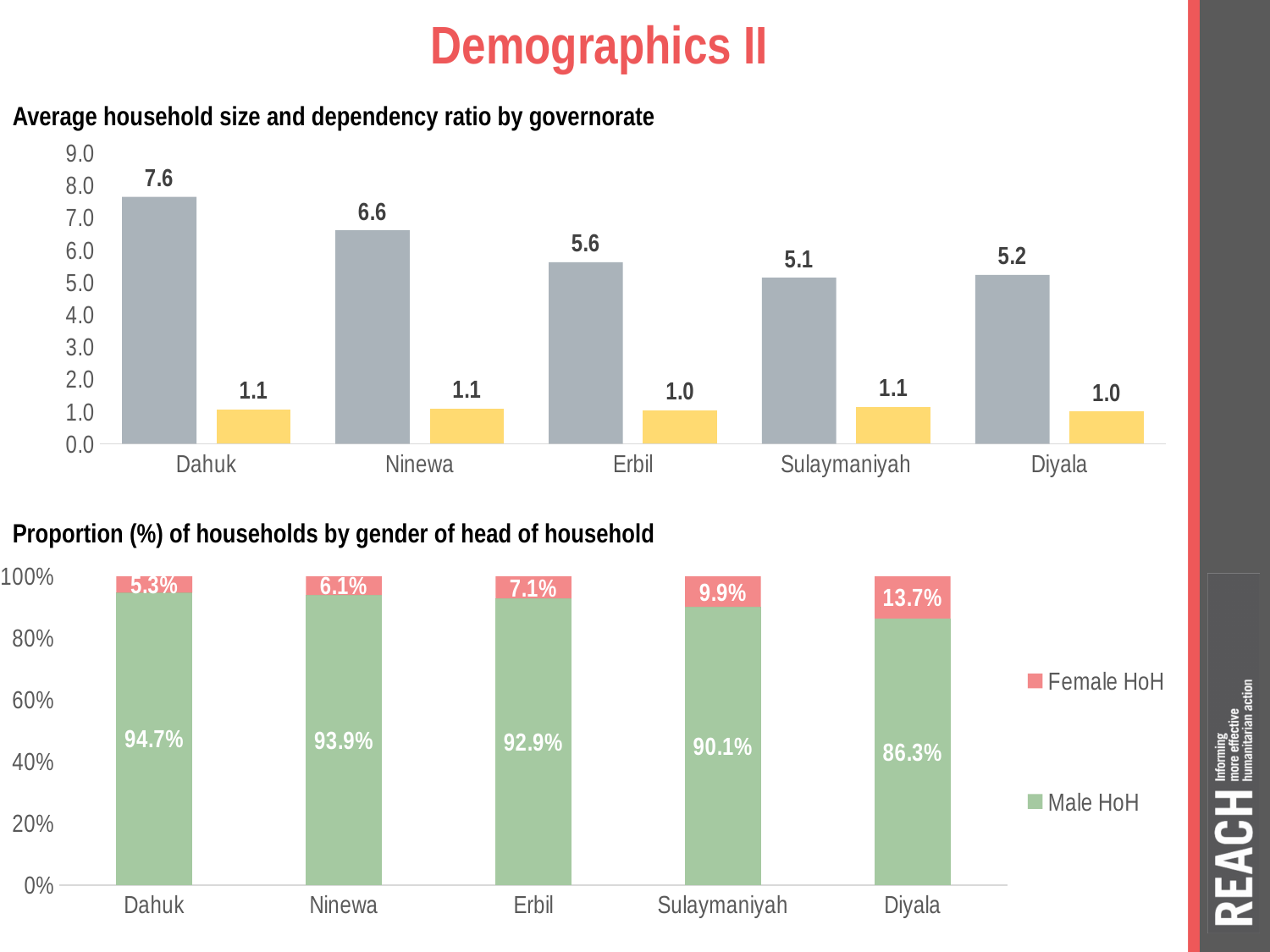
In the 'Average household size and dependency ratio by governorate' chart, what is the value of the grey bar for Dahuk? 7.6 In the 'Proportion (%) of households by gender of head of household' chart, does the Male HoH share rise or fall from Dahuk to Diyala along the x axis? fall In the 'Average household size and dependency ratio by governorate' chart, which governorate has the highest grey bar? Dahuk In the 'Proportion (%) of households by gender of head of household' chart, what is the Male HoH value for Sulaymaniyah? 90.1% In the 'Average household size and dependency ratio by governorate' chart, what is the value of the yellow bar for Erbil? 1.0 In the 'Average household size and dependency ratio by governorate' chart, how many governorates are shown on the x axis? 5 In the 'Proportion (%) of households by gender of head of household' chart, what is the Female HoH value for Diyala? 13.7% In the 'Average household size and dependency ratio by governorate' chart, which governorate has the lowest grey bar? Sulaymaniyah In the 'Average household size and dependency ratio by governorate' chart, what is the difference between the grey bar values for Dahuk and Ninewa? 1.0 In the 'Proportion (%) of households by gender of head of household' chart, which governorate has the highest Female HoH share? Diyala In the 'Proportion (%) of households by gender of head of household' chart, how many series does the legend list? 2 In the 'Average household size and dependency ratio by governorate' chart, is the grey bar for Diyala greater or less than the grey bar for Sulaymaniyah? greater